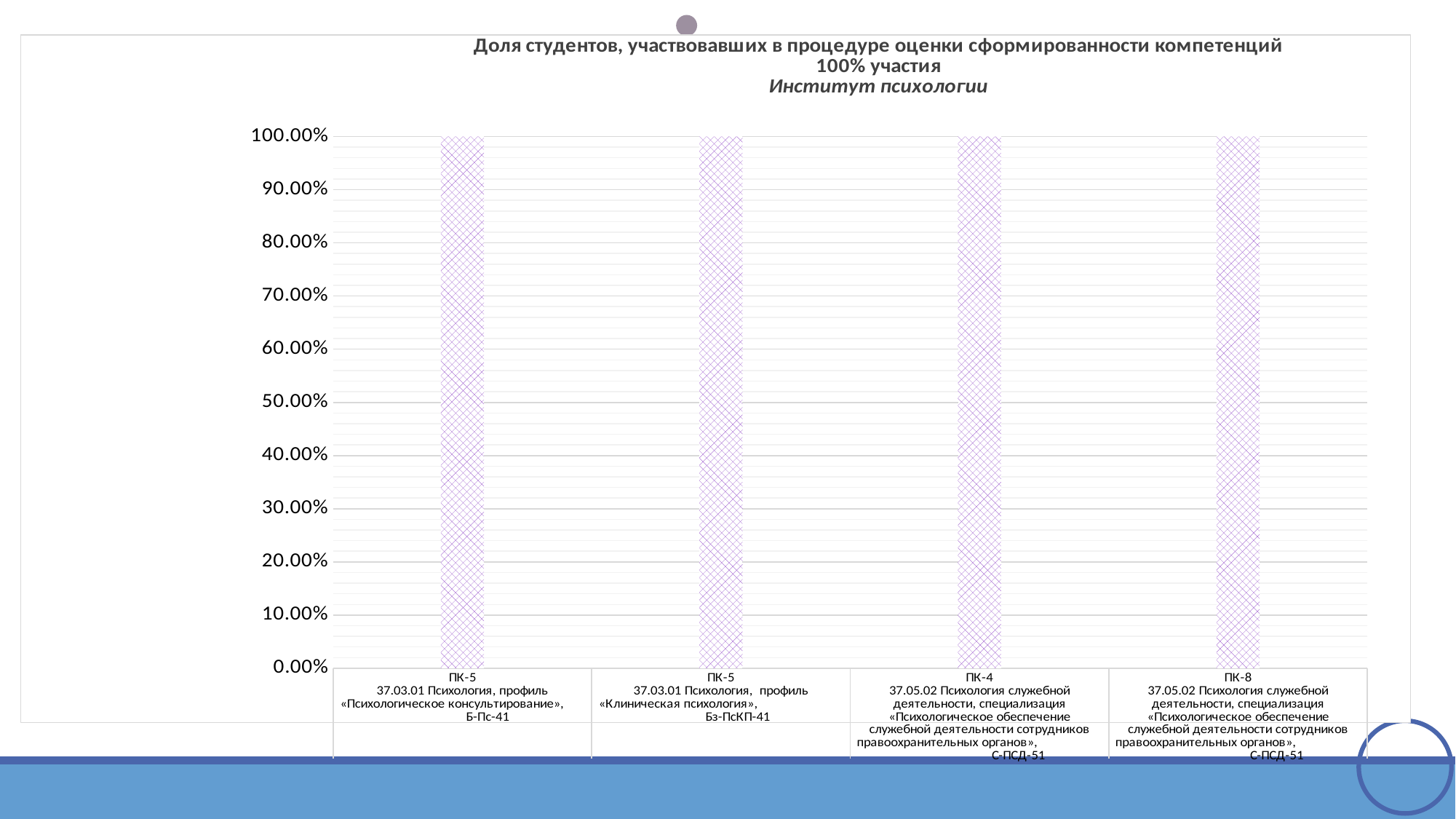
What is the difference between the value for ПК-5 (Б-Пс-41) and the value for ПК-8 (С-ПСД-51)? 0.00% Is the value for ПК-5 (Б-Пс-41) greater or less than 50.00%? greater What kind of chart is shown on the slide? bar chart Which institute is named in the chart title? Институт психологии Do the values rise, fall, or stay the same across the categories from left to right? stay the same Is the value for ПК-4 (С-ПСД-51) greater or less than 90.00%? greater What is the value for ПК-5, 37.03.01 Психология, профиль «Психологическое консультирование», Б-Пс-41? 100.00% What is the value for ПК-4, 37.05.02 Психология служебной деятельности, С-ПСД-51? 100.00% What is the highest value shown on the vertical axis? 100.00% What is the value for ПК-8, 37.05.02 Психология служебной деятельности, С-ПСД-51? 100.00% How many bars (categories) are plotted in the chart? 4 What is the value for ПК-5, 37.03.01 Психология, профиль «Клиническая психология», Бз-ПсКП-41? 100.00%